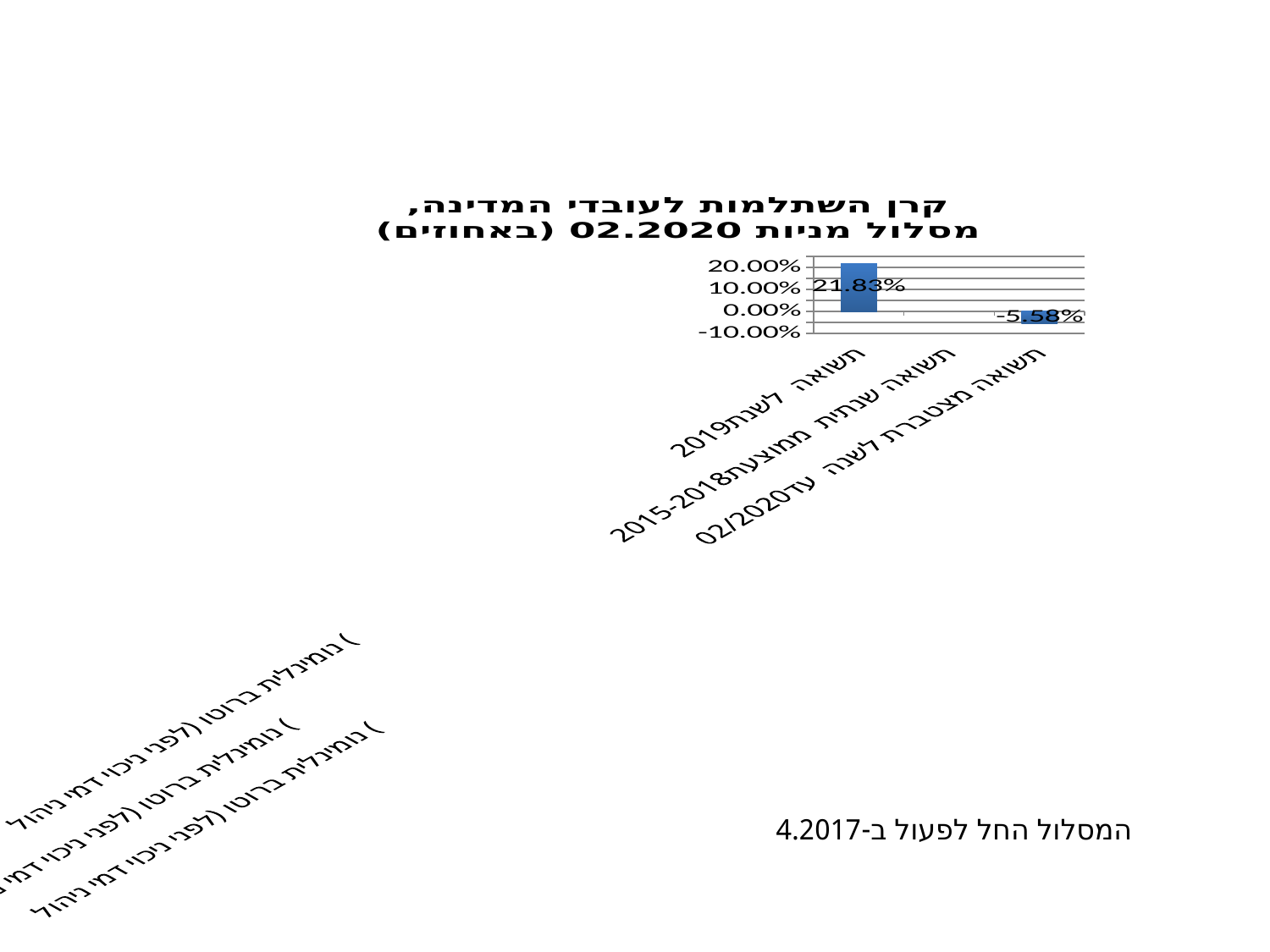
Which category has the lowest value in the chart? תשואה מצטברת לשנה עד 02/2020 How many bars with data labels are plotted in the chart? 2 Is the value for תשואה מצטברת לשנה עד 02/2020 greater or less than 0.00%? less What is the difference between the value for תשואה לשנת 2019 and the value for תשואה מצטברת לשנה עד 02/2020? 27.41 percentage points What is the value shown for תשואה לשנת 2019? 21.83% Which is larger: the value for תשואה לשנת 2019 or the value for תשואה מצטברת לשנה עד 02/2020? תשואה לשנת 2019 Is the value for תשואה לשנת 2019 greater or less than 20.00%? greater What kind of chart is shown on the slide? bar chart What is the value shown for תשואה מצטברת לשנה עד 02/2020? -5.58% Which category has the highest value in the chart? תשואה לשנת 2019 What is the title of the chart? קרן השתלמות לעובדי המדינה, מסלול מניות 02.2020 (באחוזים) How many categories are labelled on the x axis of the chart? 3